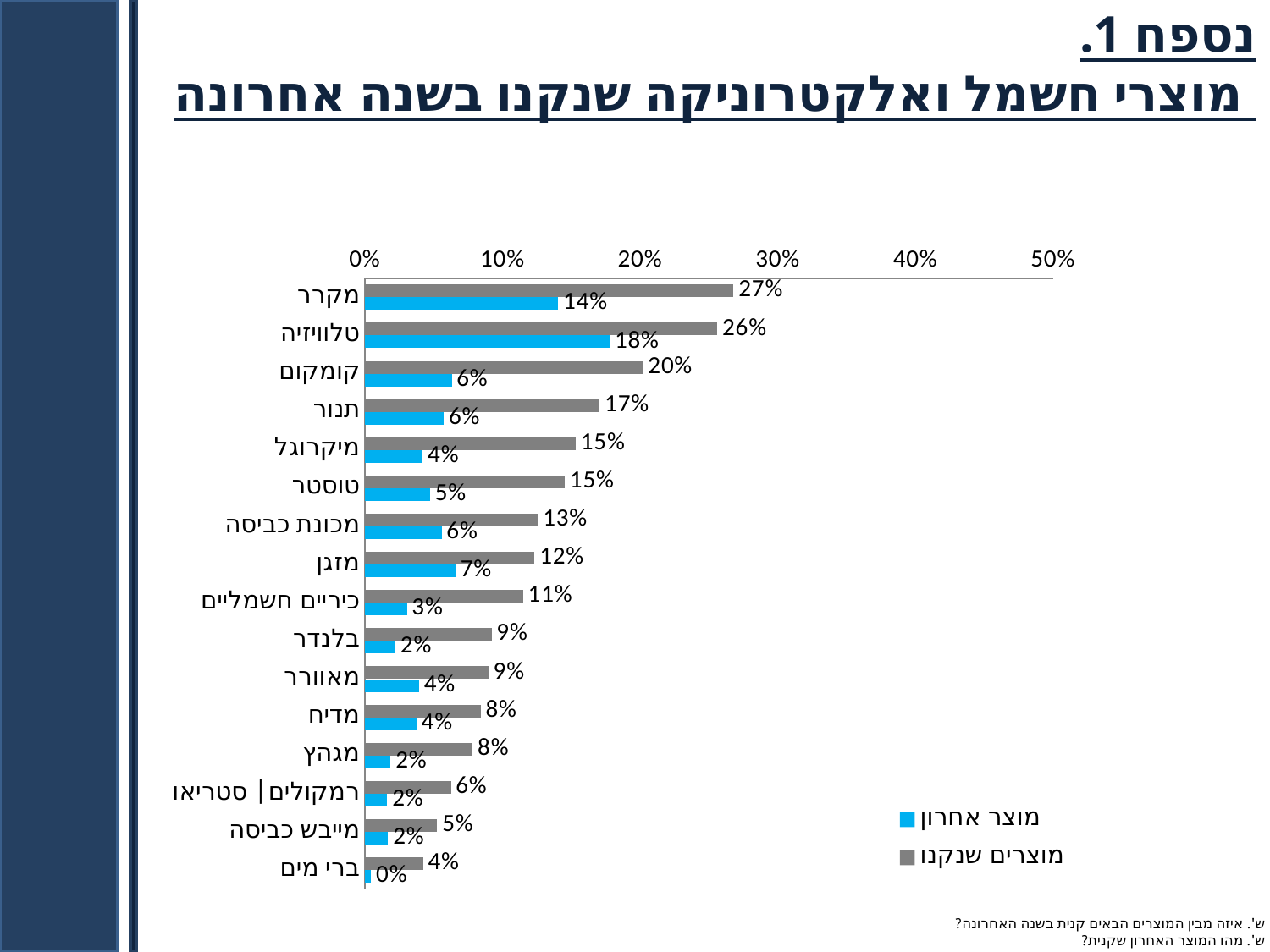
How many series does the legend list? 2 What is the value of מוצרים שנקנו for מקרר? 27% Which category has the lowest value for מוצר אחרון? ברי מים Which is larger for מוצר אחרון: מזגן or מיקרוגל? מזגן Which category has the highest value for מוצרים שנקנו? מקרר How many categories are shown in the chart? 16 What is the value of מוצר אחרון for ברי מים? 0% Which series is shown in blue? מוצר אחרון What is the value of מוצר אחרון for טלוויזיה? 18% What is the difference between מוצרים שנקנו and מוצר אחרון for מקרר? 13% What is the value of מוצרים שנקנו for קומקום? 20% What kind of chart is shown on the slide? Bar chart